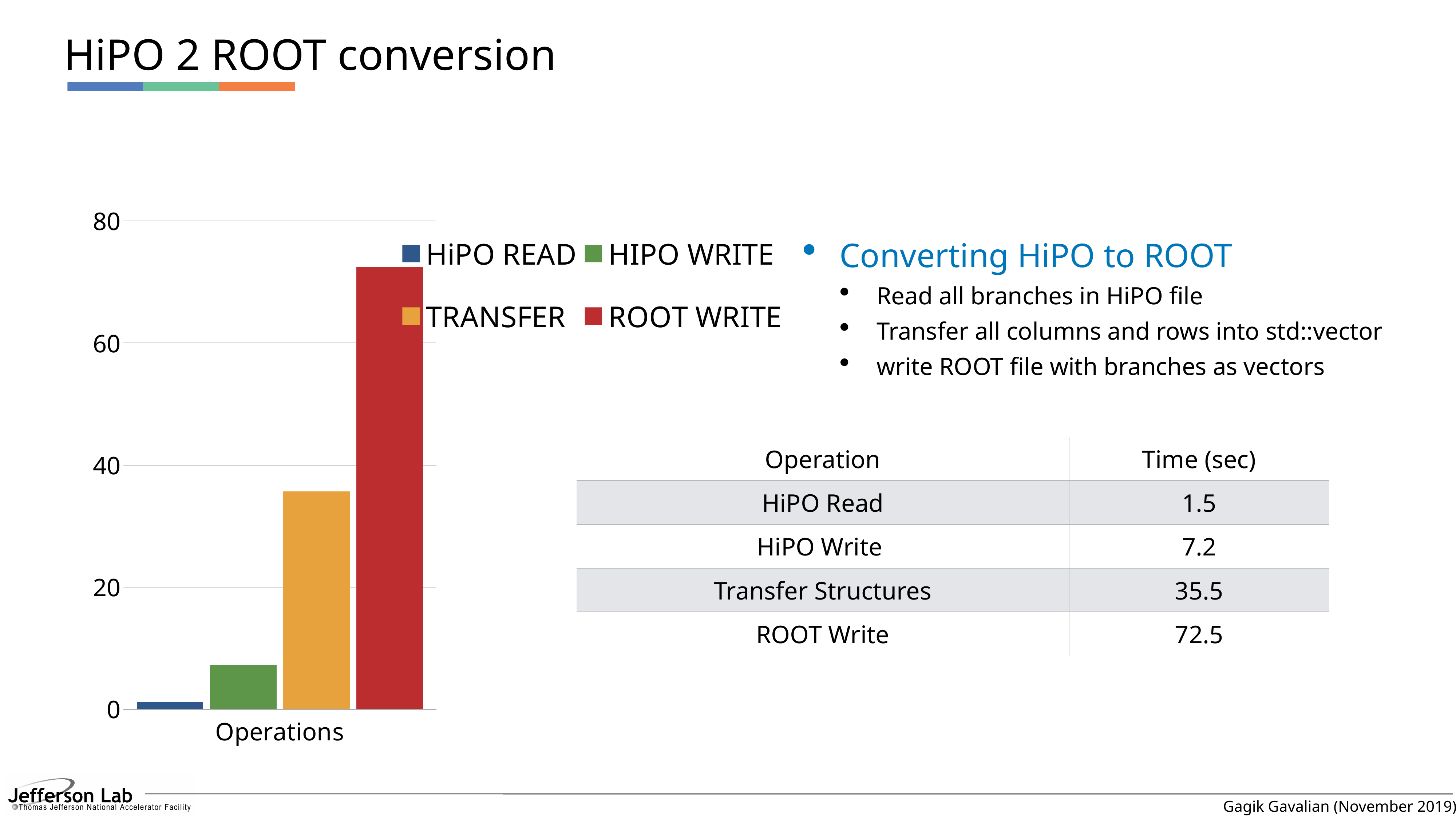
How many categories are shown on the x axis of the chart? 1 What is the label on the x axis of the chart? Operations Is the value for TRANSFER greater or less than 40? less According to the table on the slide, what is the time in seconds for ROOT Write? 72.5 Which is larger, the TRANSFER bar or the HIPO WRITE bar? TRANSFER What kind of chart is shown on the slide? bar chart How many series does the chart legend list? 4 Which series has the shortest bar in the chart? HiPO READ Which series has the tallest bar in the chart? ROOT WRITE Is the value for ROOT WRITE greater or less than 60? greater According to the table on the slide, what is the time in seconds for Transfer Structures? 35.5 Is the value for HIPO WRITE greater or less than 20? less